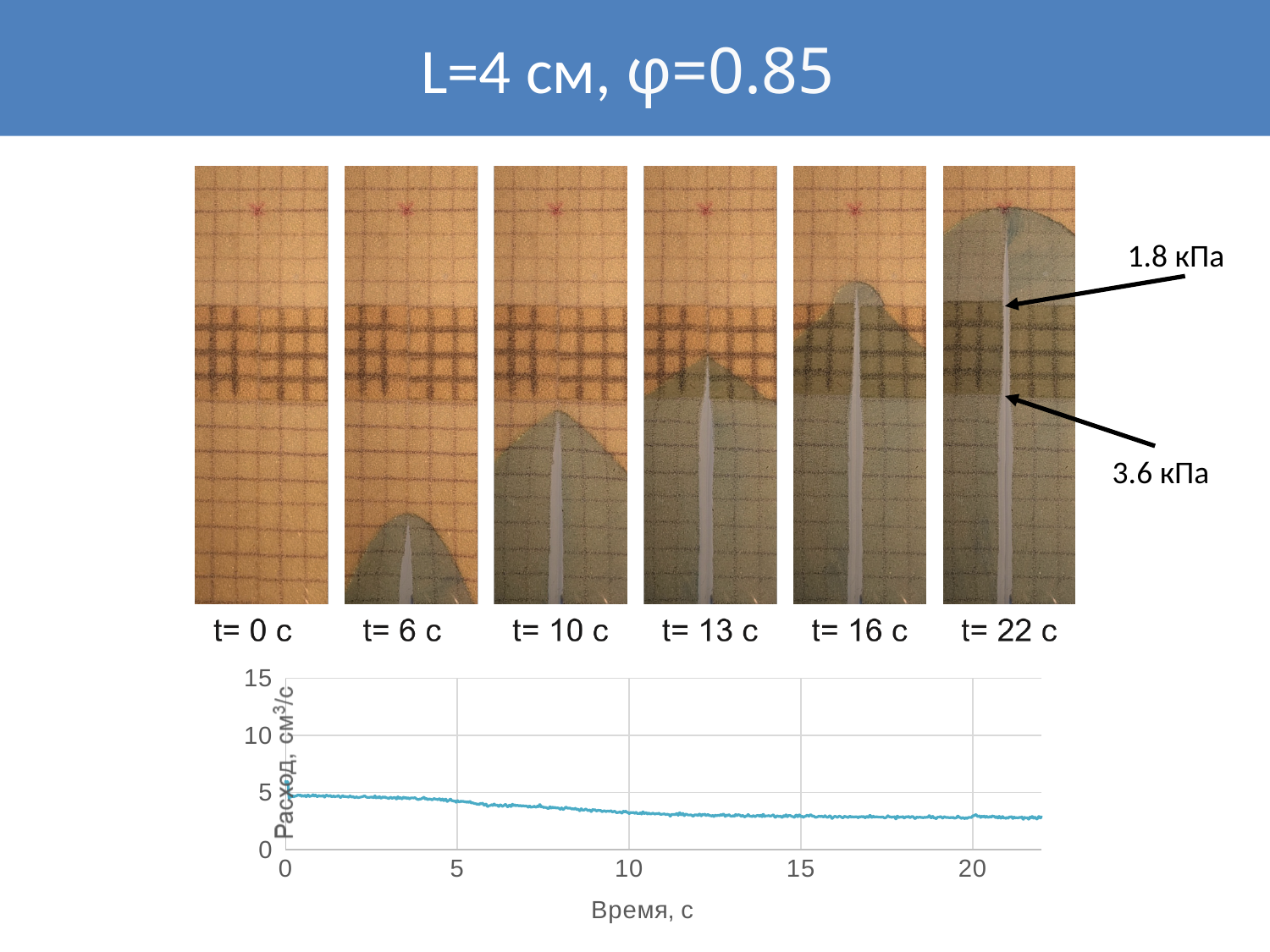
Is the flow rate at time 20 с greater or less than 5 см³/с? less What is the label of the x axis of the chart? Время, с Does the flow rate (Расход) rise or fall as time increases along the x axis? fall Is the flow rate at time 15 с greater or less than 10 см³/с? less Is the flow rate at time 10 с greater or less than 5 см³/с? less Which is larger, the flow rate at time 2 с or at time 20 с? time 2 с What kind of chart is shown at the bottom of the slide? line chart How many data series are plotted on the chart? 1 What is the maximum value shown on the y axis of the chart? 15 What is the label of the y axis of the chart? Расход, см³/с